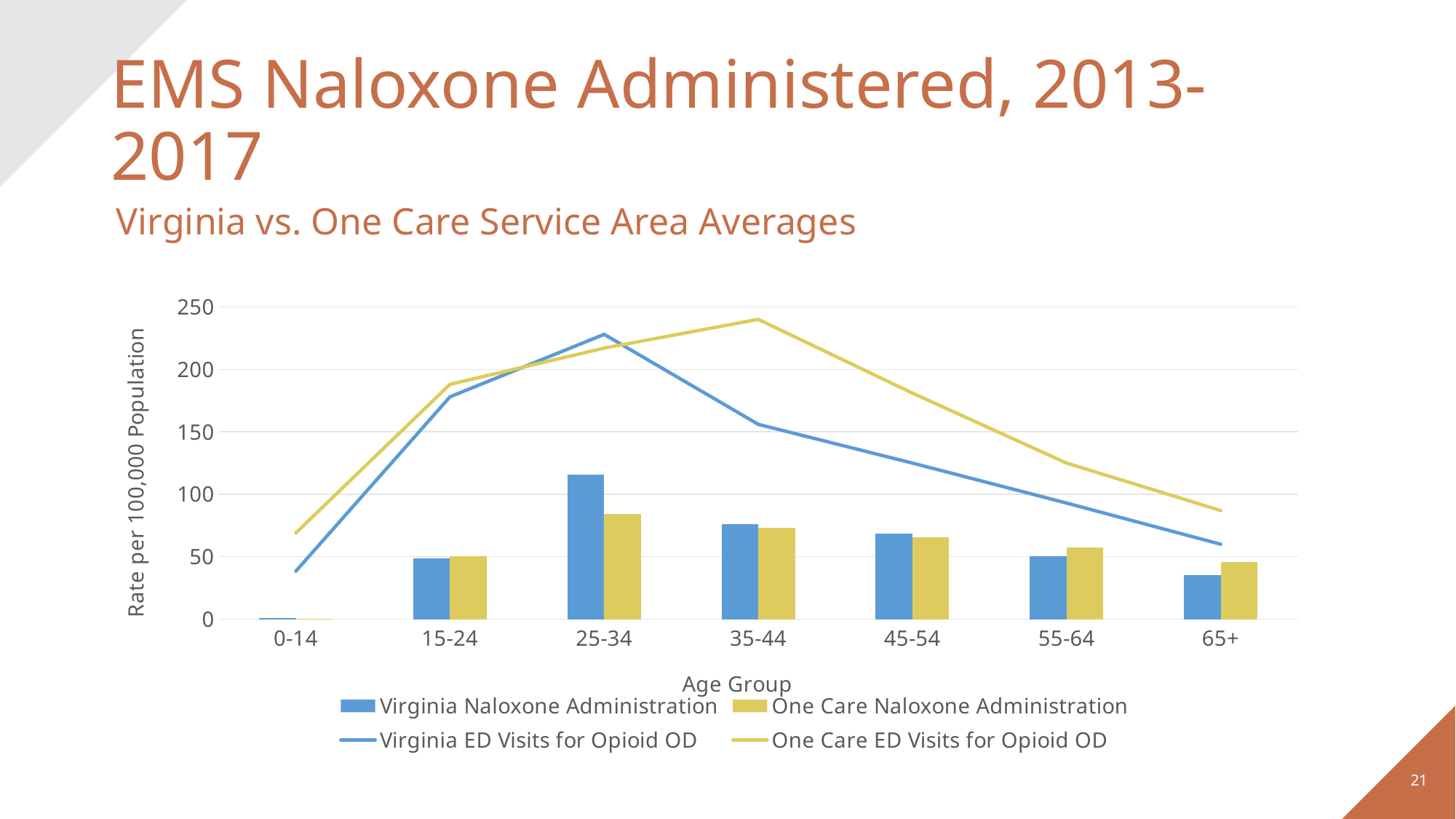
Which age group has the highest Virginia Naloxone Administration rate? 25-34 Which age group has the lowest Virginia Naloxone Administration rate? 0-14 Which age group has the highest One Care ED Visits for Opioid OD rate? 35-44 How many series does the legend list? 4 How many age groups are shown on the x axis? 7 Is the Virginia ED Visits for Opioid OD rate for the 0-14 age group greater or less than 50? less Which age group has the highest Virginia ED Visits for Opioid OD rate? 25-34 For the 65+ age group, which is larger: Virginia Naloxone Administration or One Care Naloxone Administration? One Care Naloxone Administration Is the One Care ED Visits for Opioid OD rate for the 35-44 age group greater or less than 200? greater For the 25-34 age group, which is larger: Virginia Naloxone Administration or One Care Naloxone Administration? Virginia Naloxone Administration What kind of chart is shown on the slide? A combined bar and line chart Is the Virginia Naloxone Administration rate for the 25-34 age group greater or less than 100? greater